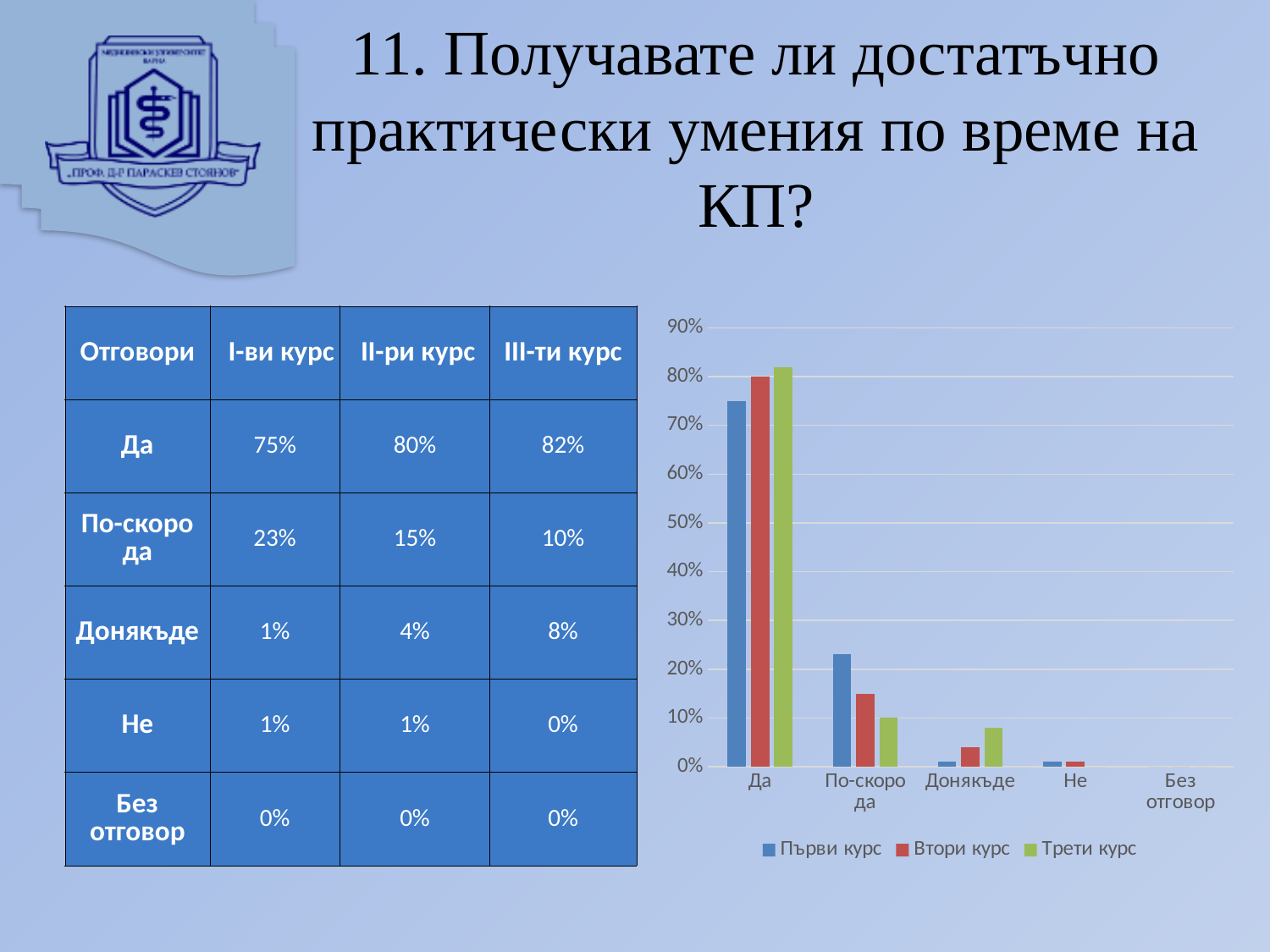
Which series is shown in red in the chart? Втори курс What is the difference between the Трети курс and Първи курс values in the Да category, using the table values? 7% Is the value for Втори курс in the По-скоро да category greater or less than 20%? less How many series does the chart legend list? 3 Is the value for Първи курс in the Да category greater or less than 70%? greater How many categories are shown on the x axis of the chart? 5 Which category has the highest value for the Трети курс series? Да Which series has the larger value in the По-скоро да category, Първи курс or Трети курс? Първи курс What is the value for Първи курс in the По-скоро да category, as printed in the table? 23% What kind of chart is shown on the slide? bar chart What is the value for Трети курс in the Да category, as printed in the table? 82% Which series has the larger value in the Донякъде category, Втори курс or Трети курс? Трети курс